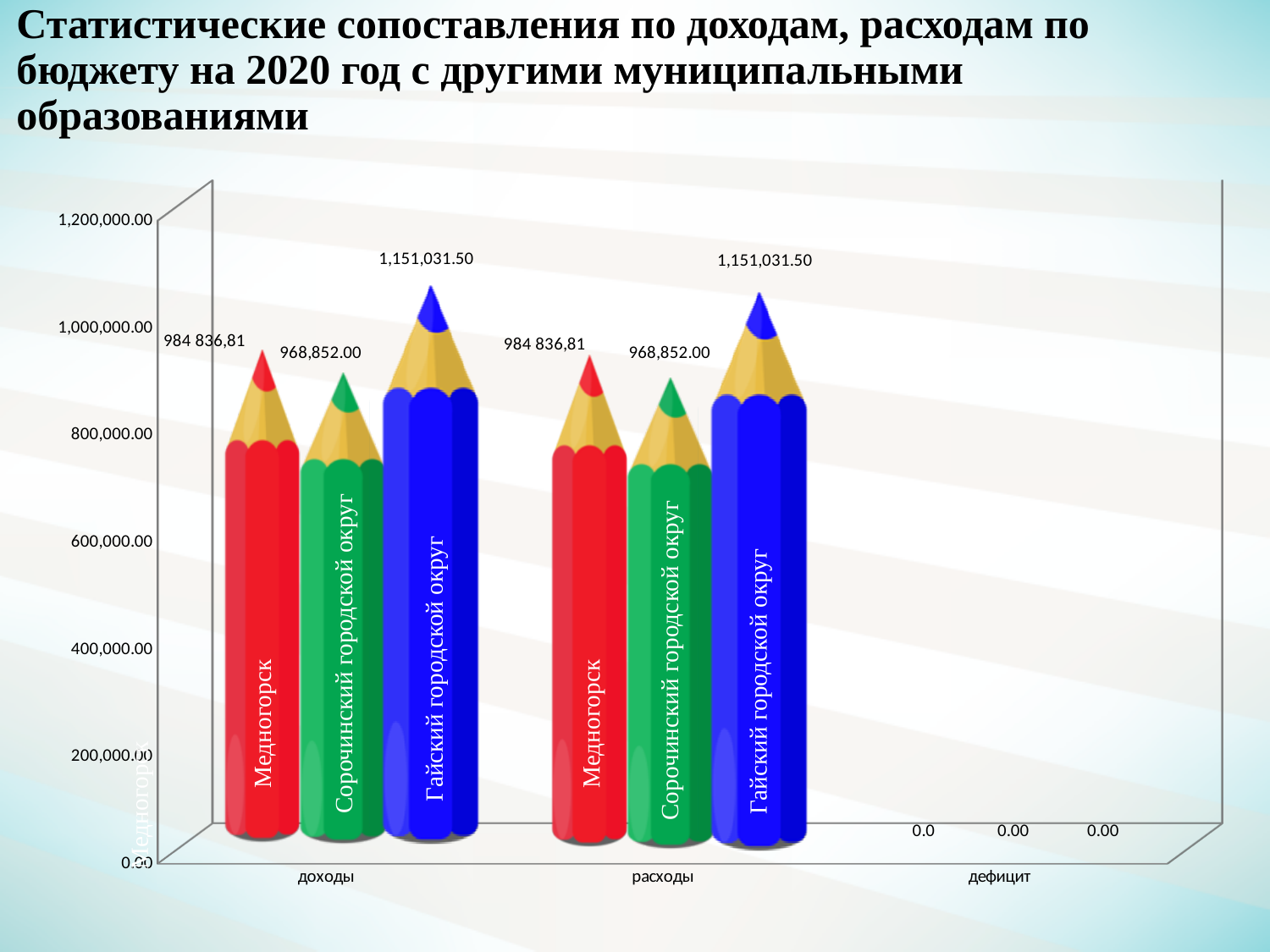
In the расходы category, which is larger: the value for Медногорск or the value for Сорочинский городской округ? Медногорск What is the value for Медногорск in the доходы category? 984 836,81 Is the value for Гайский городской округ in the доходы category greater or less than 1,000,000.00? greater What kind of chart is shown on the slide? bar chart How many categories are shown on the x axis of the chart? 3 What value is shown for the дефицит category for all three municipalities? 0.00 What is the value for Сорочинский городской округ in the расходы category? 968,852.00 Which municipality has the lowest value in the доходы category? Сорочинский городской округ Which municipality has the highest value in the расходы category? Гайский городской округ What is the difference between the доходы values of Гайский городской округ and Сорочинский городской округ? 182,179.50 What is the value for Гайский городской округ in the доходы category? 1,151,031.50 What colour are the bars for Гайский городской округ? blue